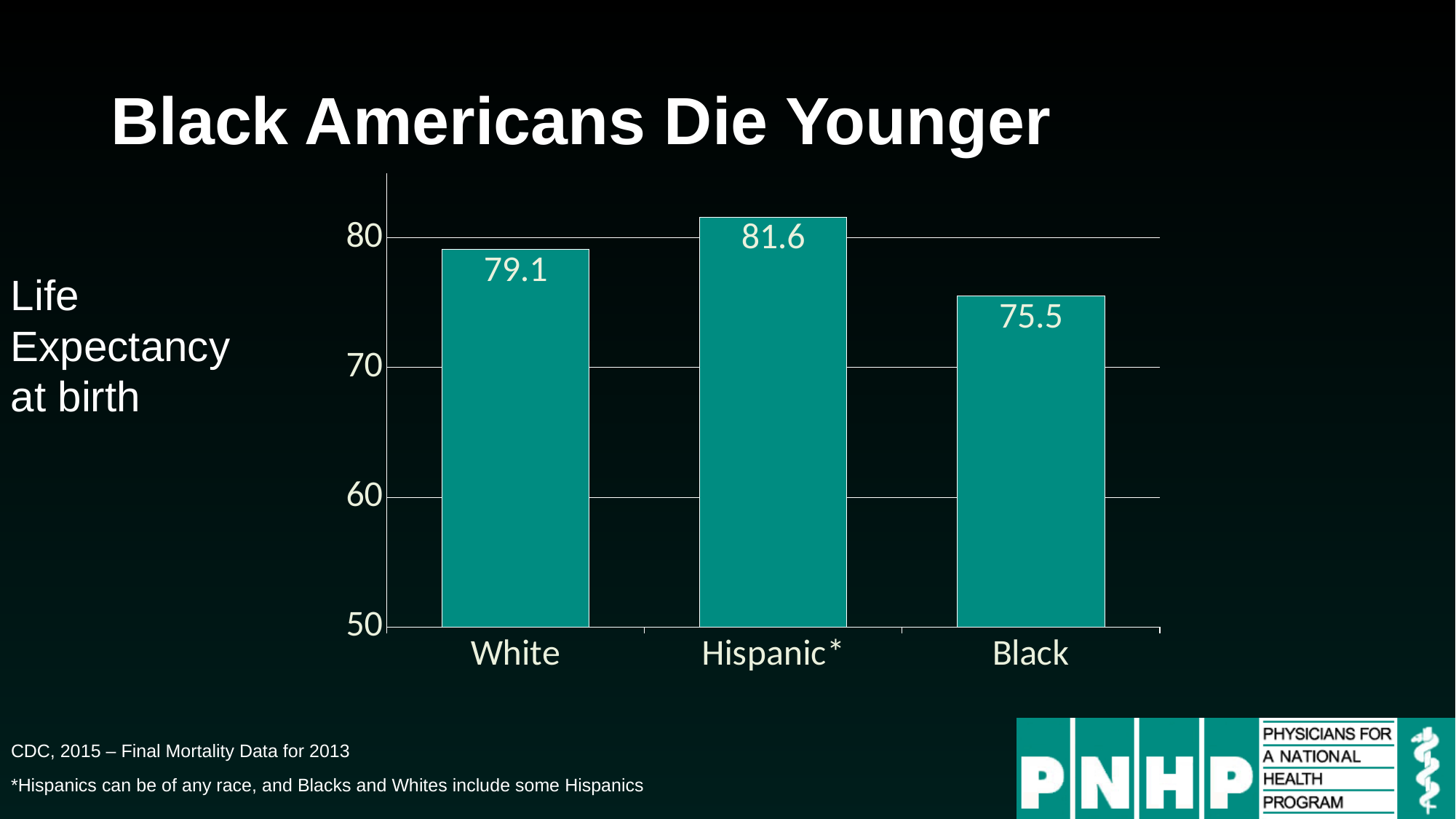
How many groups are shown on the chart? 3 Is the life expectancy for Black Americans greater or less than 80? less What kind of chart is shown on the slide? bar chart What is the difference in life expectancy between Hispanic and Black Americans on the chart? 6.1 Which group has the lowest life expectancy at birth on the chart? Black Which group has a higher life expectancy at birth, White or Hispanic? Hispanic* What is the life expectancy at birth for Hispanic Americans shown on the chart? 81.6 What is the life expectancy at birth for Black Americans shown on the chart? 75.5 What is the life expectancy at birth for White Americans shown on the chart? 79.1 What is the title of the slide containing the chart? Black Americans Die Younger What is the difference in life expectancy between White and Black Americans on the chart? 3.6 Which group has the highest life expectancy at birth on the chart? Hispanic*